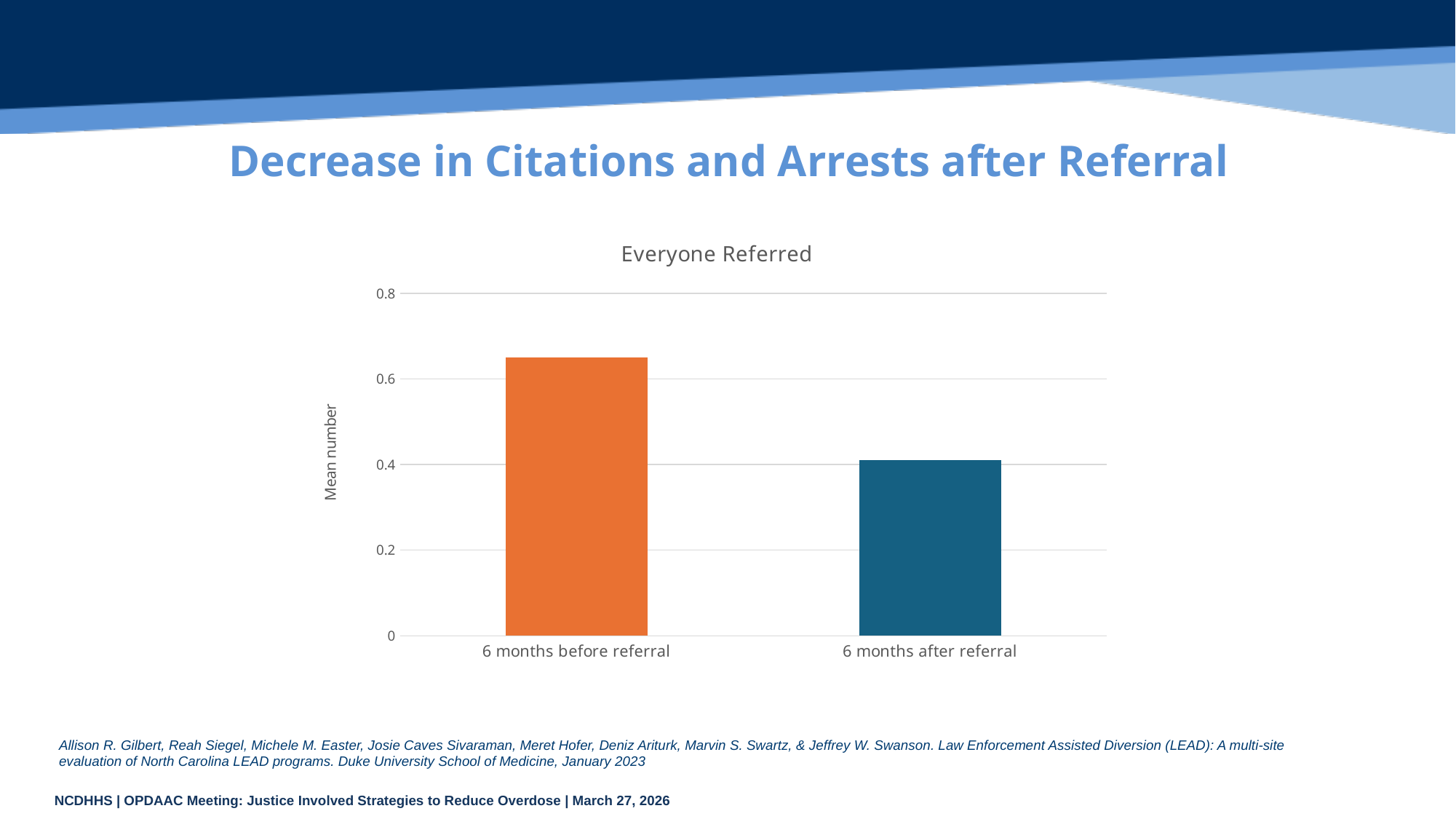
Is the value for 6 months before referral greater or less than 0.8? less What is the title of the chart? Everyone Referred Which is larger, the value for 6 months before referral or the value for 6 months after referral? 6 months before referral Which category has the lowest value in the chart? 6 months after referral Do the values rise or fall from 6 months before referral to 6 months after referral? fall Is the value for 6 months before referral greater or less than 0.6? greater Is the value for 6 months after referral greater or less than 0.6? less What kind of chart is shown on the slide? bar chart Which category has the highest value in the chart? 6 months before referral How many bars are plotted in the chart? 2 What is the label on the vertical axis of the chart? Mean number